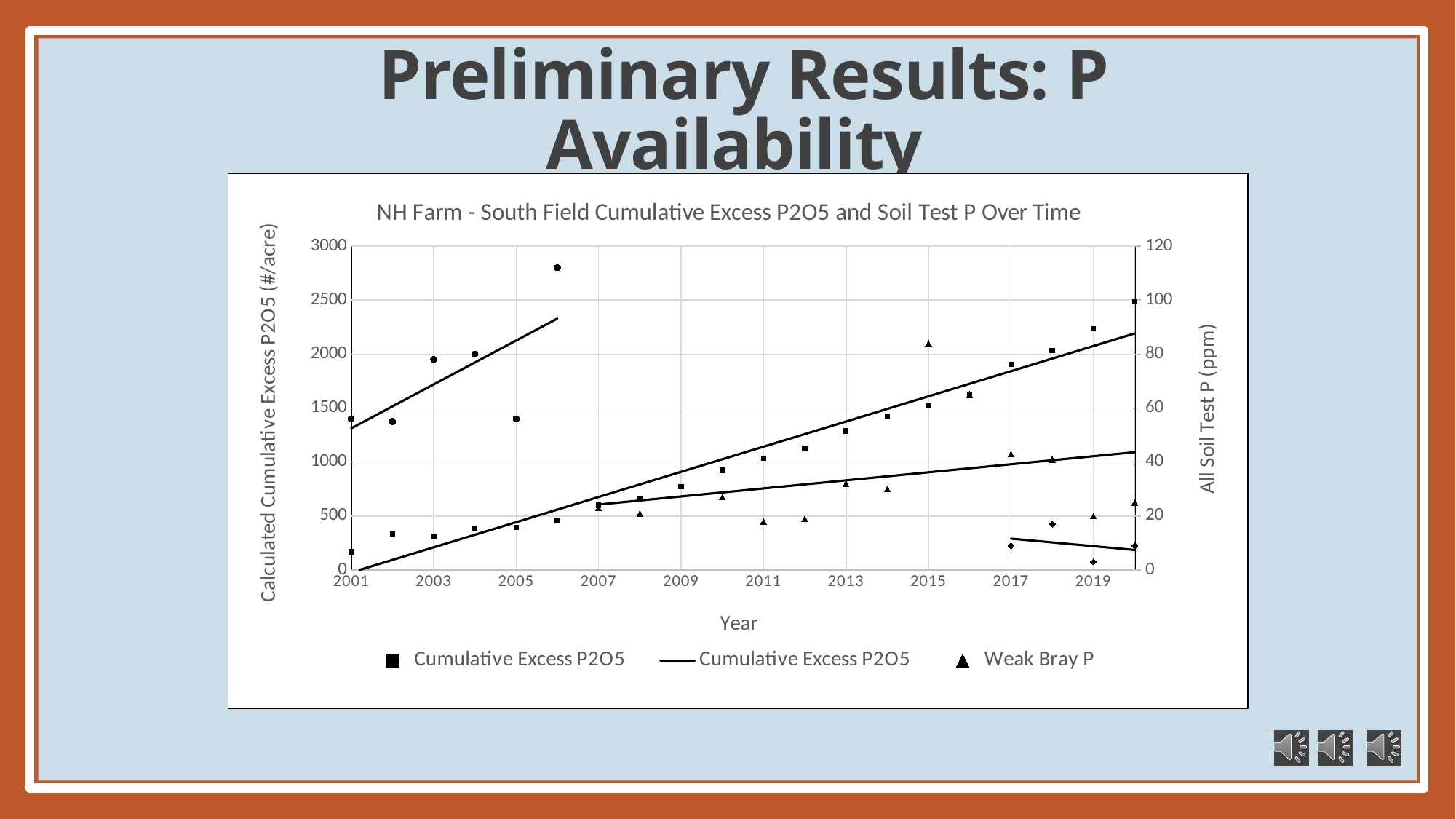
How many series does the chart legend list? 3 What is the highest value shown on the left vertical axis? 3000 Is the Cumulative Excess P2O5 value for 2011 greater or less than 1500? less What is the title of the chart? NH Farm - South Field Cumulative Excess P2O5 and Soil Test P Over Time Do the Cumulative Excess P2O5 values rise or fall from 2001 to 2020? rise Is the Cumulative Excess P2O5 value for 2017 greater or less than 1500? greater Is the Cumulative Excess P2O5 value for 2019 greater or less than 2000? greater Which year has the larger Cumulative Excess P2O5 value, 2001 or 2019? 2019 What kind of chart is shown on the slide? scatter chart What is the label of the x axis? Year